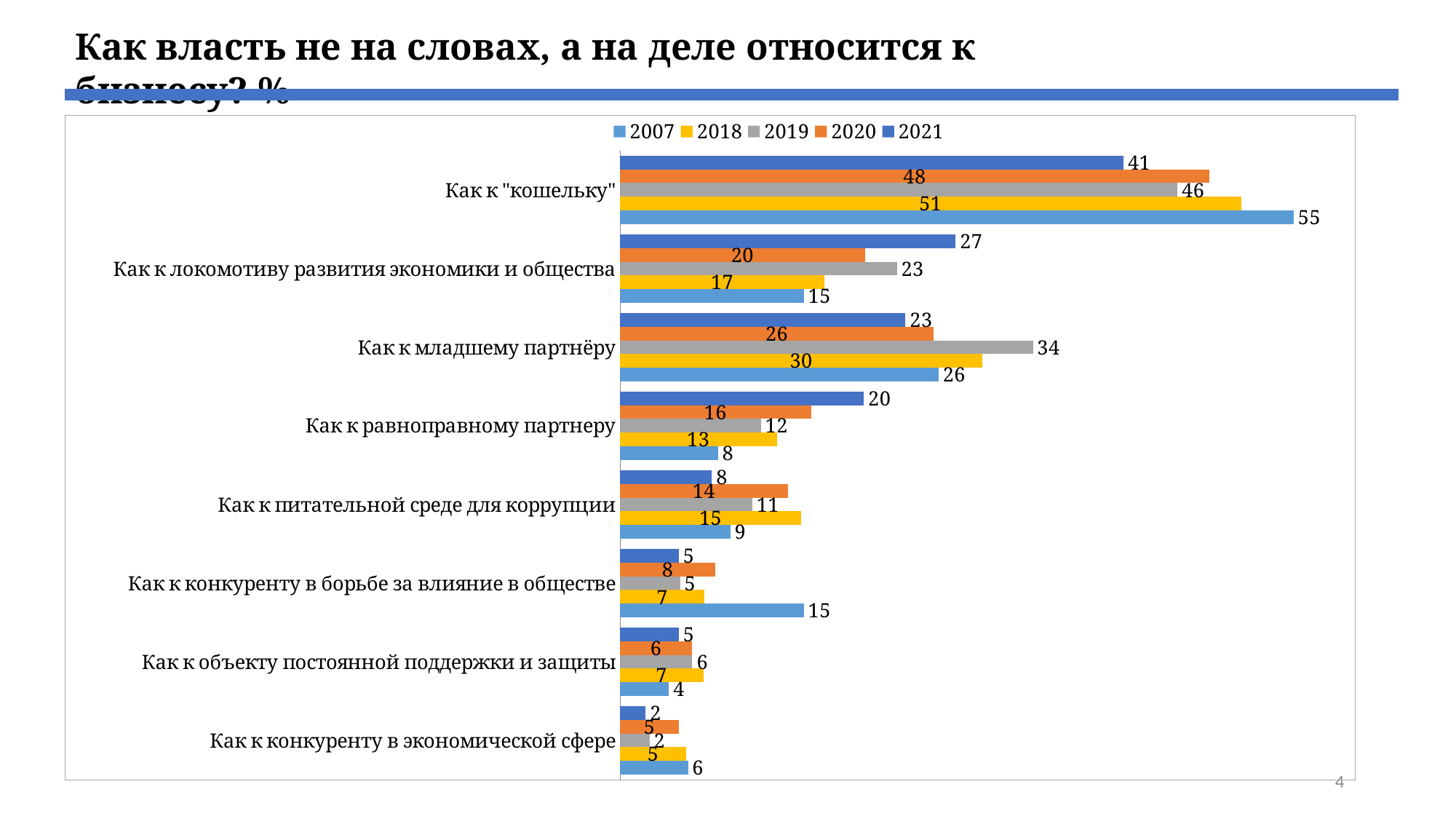
How many series does the legend list? 5 Which year is shown in orange in the legend? 2020 What is the value for 2019 in the category Как к младшему партнёру? 34 How many categories are shown on the chart? 8 What is the value for 2007 in the category Как к "кошельку"? 55 For Как к равноправному партнеру, which is larger: the value for 2021 or the value for 2007? 2021 Does the value for Как к "кошельку" rise or fall from 2018 to 2021? fall Which category has the lowest value for 2007? Как к объекту постоянной поддержки и защиты What kind of chart is shown on the slide? bar chart What is the value for 2021 in the category Как к локомотиву развития экономики и общества? 27 Which category has the highest value for 2021? Как к "кошельку" What is the difference between the 2007 and 2021 values for Как к "кошельку"? 14